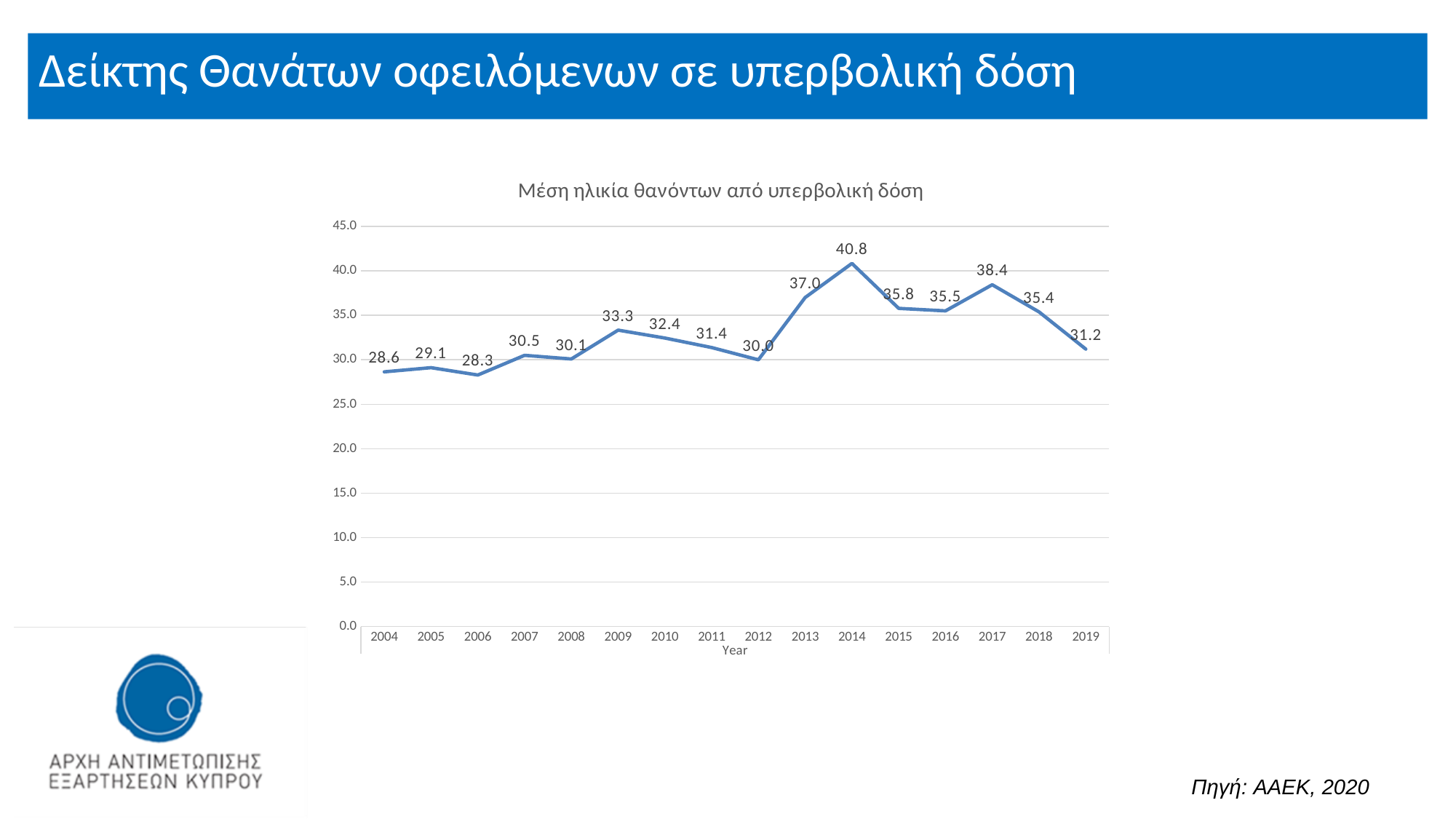
What is the title of the chart? Μέση ηλικία θανόντων από υπερβολική δόση What is the value for 2014? 40.8 What is the difference between the values for 2014 and 2013? 3.8 Is the value for 2012 greater or less than 35.0? less What kind of chart is shown? line chart Which is larger, the value for 2017 or the value for 2018? 2017 What is the value for 2004? 28.6 What is the value for 2019? 31.2 Which year has the lowest value? 2006 Which year has the highest value? 2014 How many years are plotted on the x axis? 16 Do the values rise or fall from 2014 to 2016? fall